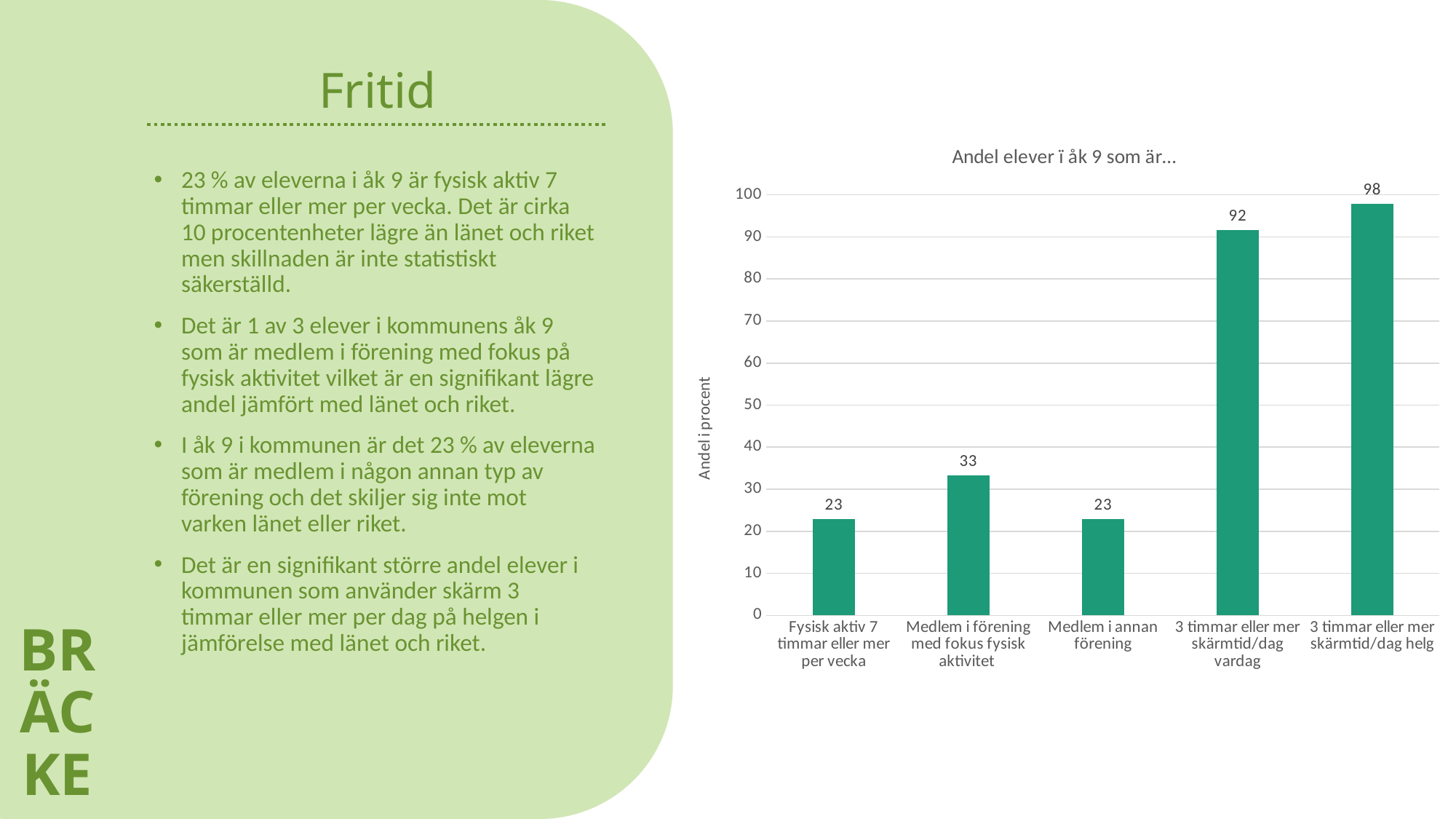
What kind of chart is shown on the slide? Bar chart Is the value for '3 timmar eller mer skärmtid/dag vardag' greater or less than 80? greater Which is larger: the value for 'Medlem i förening med fokus fysisk aktivitet' or the value for 'Fysisk aktiv 7 timmar eller mer per vecka'? Medlem i förening med fokus fysisk aktivitet What is the value for 'Medlem i förening med fokus fysisk aktivitet'? 33 What is the difference between the values for 'Medlem i förening med fokus fysisk aktivitet' and 'Medlem i annan förening'? 10 Which category has the highest value? 3 timmar eller mer skärmtid/dag helg What is the title of the chart? Andel elever ï åk 9 som är… What is the value for '3 timmar eller mer skärmtid/dag helg'? 98 How many categories are shown in the chart? 5 What is the value for '3 timmar eller mer skärmtid/dag vardag'? 92 What is the difference between the values for '3 timmar eller mer skärmtid/dag helg' and '3 timmar eller mer skärmtid/dag vardag'? 6 What is the value for 'Fysisk aktiv 7 timmar eller mer per vecka'? 23